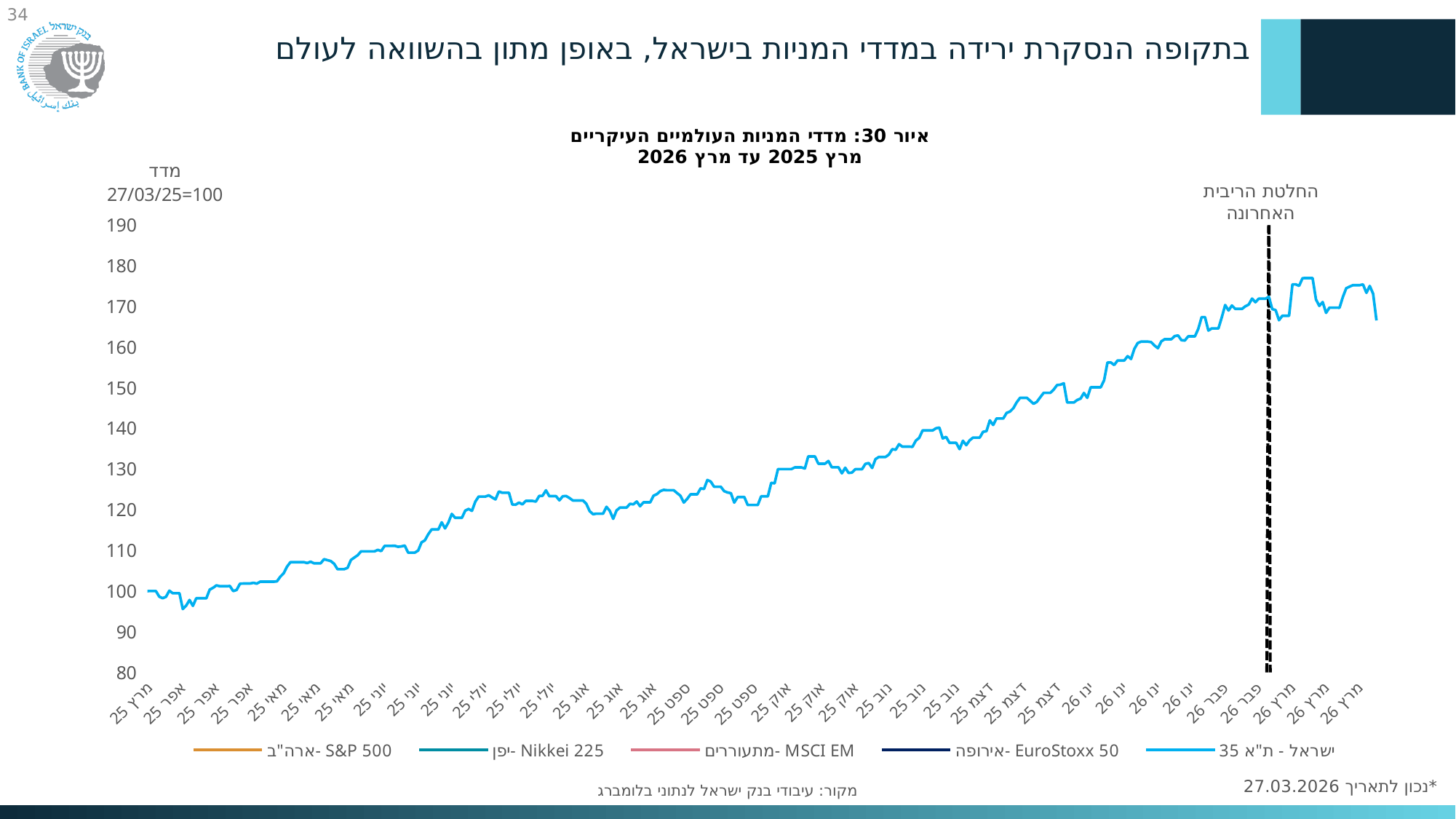
Is the highest point of the ת"א 35 line, in מרץ 26, greater or less than 170? greater How many series does the legend list? 5 Is the value of the ת"א 35 line in ינו 26 greater or less than 140? greater What kind of chart is shown on the slide? line chart Does the plotted ת"א 35 line generally rise or fall from מרץ 25 to מרץ 26? rise Is the value of the ת"א 35 line at the end of the chart (מרץ 26) greater or less than 160? greater What is the base date and value of the index on the y axis? 27/03/25=100 What does the dashed vertical line on the chart mark? החלטת הריבית האחרונה